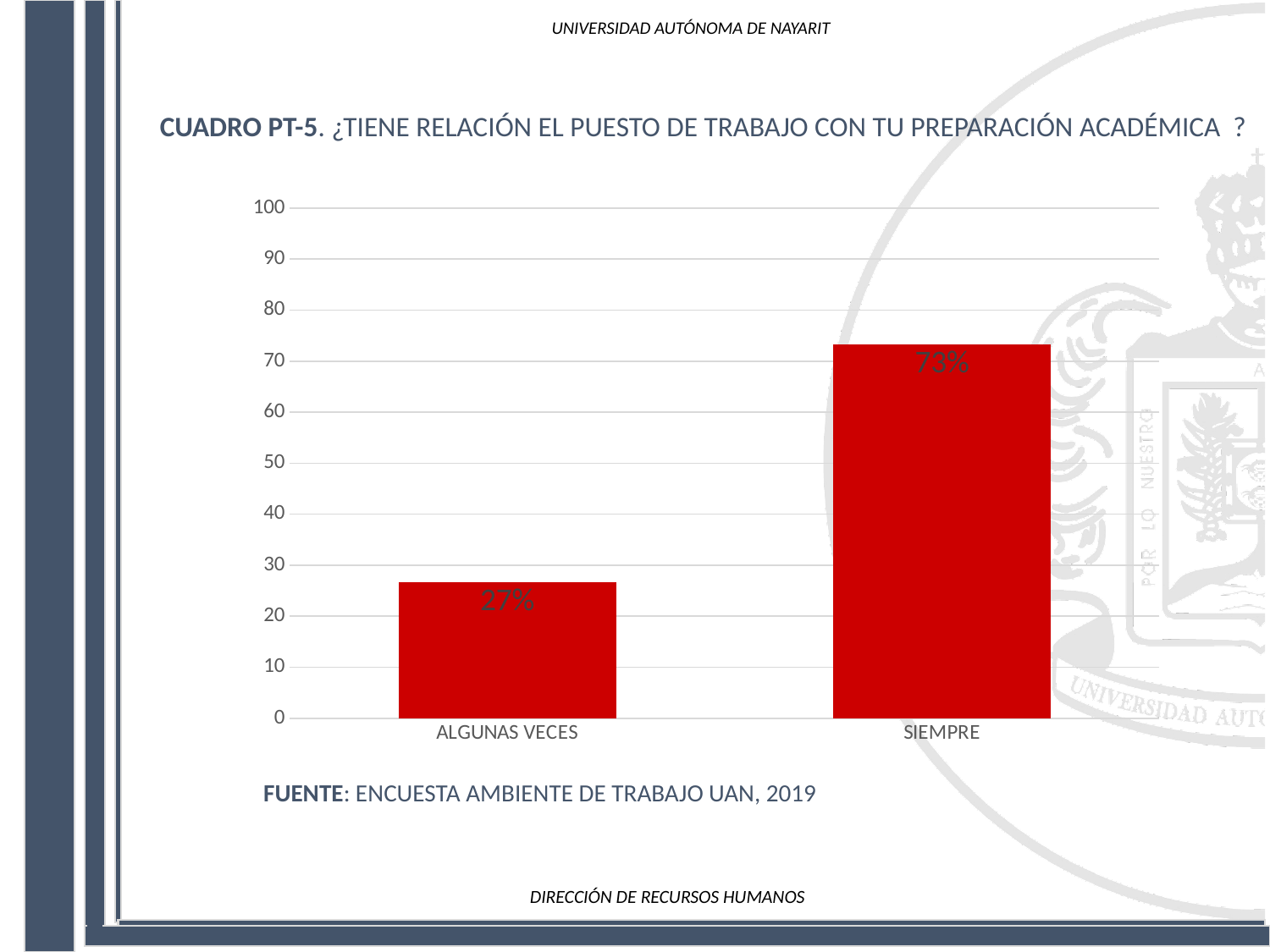
Which is larger, the value for ALGUNAS VECES or the value for SIEMPRE? SIEMPRE What colour are the bars in the chart? red What is the value for ALGUNAS VECES? 27% Which category has the highest value? SIEMPRE What is the difference between the values for SIEMPRE and ALGUNAS VECES? 46% What is the source cited below the chart? ENCUESTA AMBIENTE DE TRABAJO UAN, 2019 Which category has the lowest value? ALGUNAS VECES What kind of chart is shown on the slide? bar chart What is the value for SIEMPRE? 73% How many categories are shown on the chart? 2 Is the value for SIEMPRE greater or less than 50? greater Is the value for ALGUNAS VECES greater or less than 30? less